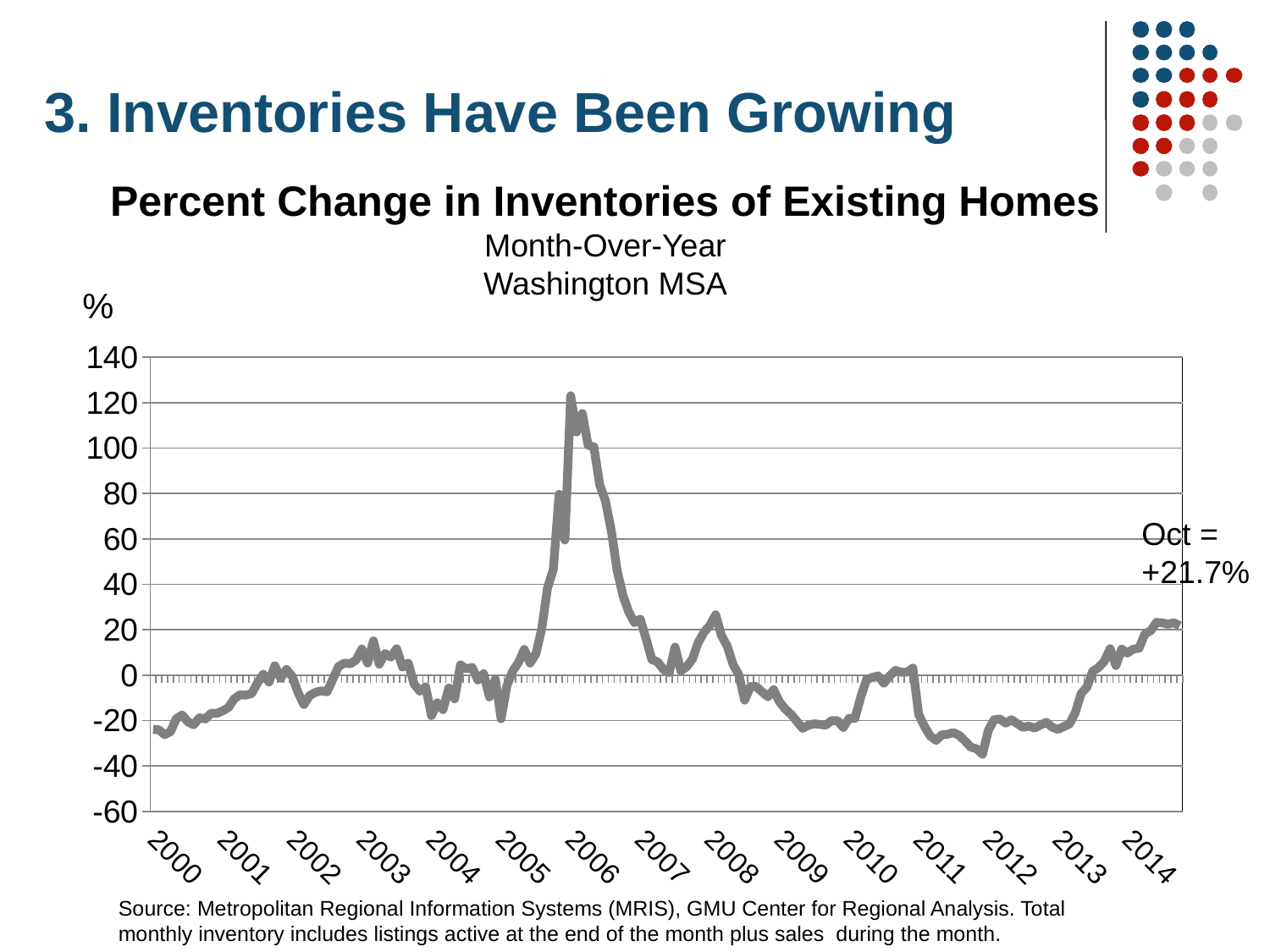
Does the line rise or fall from 2013 to 2014? rise Is the value in mid-2009 greater or less than 0? less How many year labels are shown on the x axis? 15 What is the title of the chart? Percent Change in Inventories of Existing Homes Which metropolitan area does the chart cover? Washington MSA What kind of chart is shown on the slide? line chart Is the value at the start of 2000 greater or less than 0? less Is the peak value in 2006 greater or less than 100? greater In which year does the line reach its highest peak? 2006 Which year has a higher peak, 2006 or 2008? 2006 What is the percent change in inventories for October 2014, as labeled on the chart? +21.7%